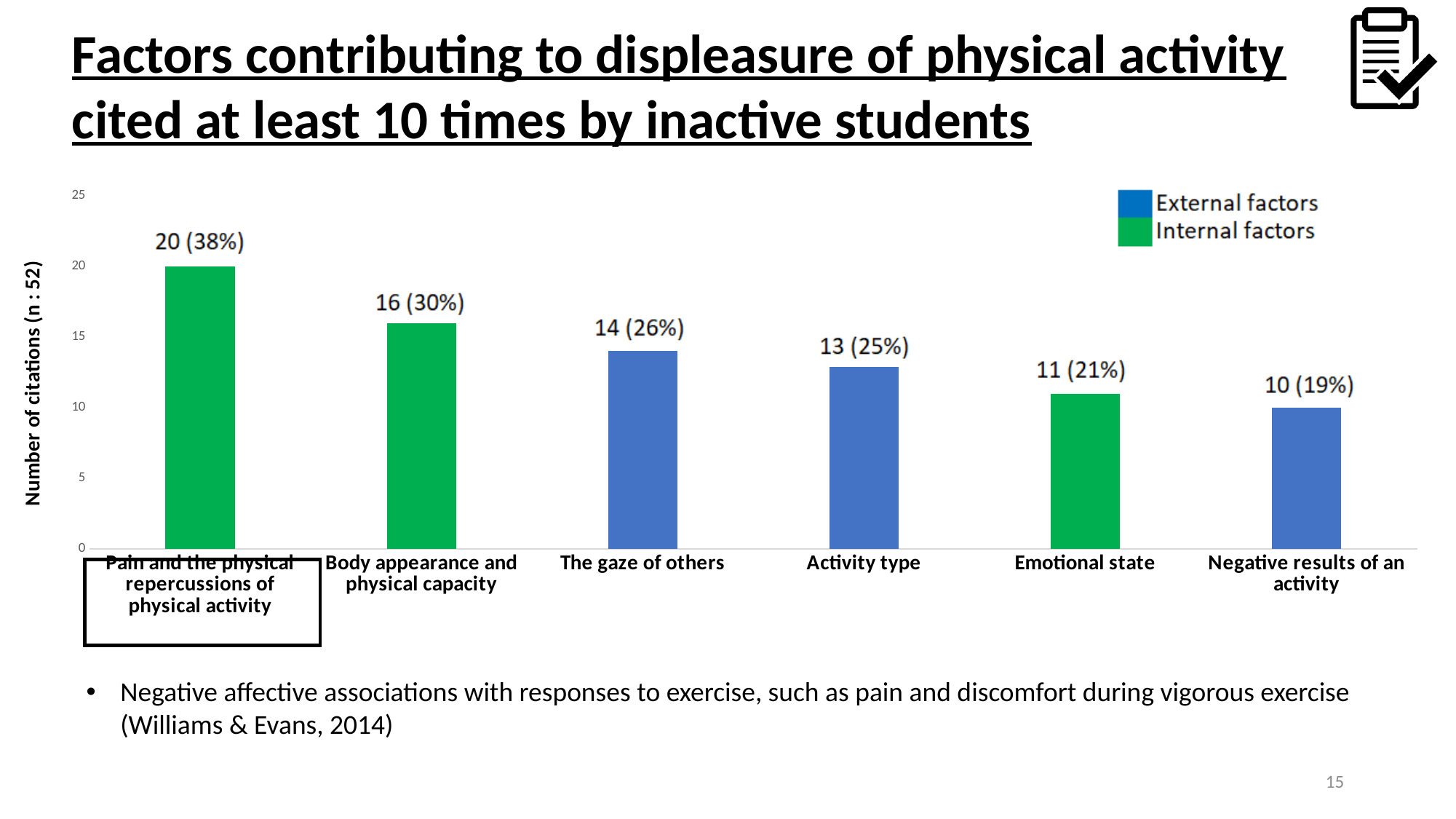
What is the data label on the bar for 'Emotional state'? 11 (21%) Do the values rise or fall from left to right along the x axis? Fall Which factor has the lowest number of citations? Negative results of an activity How many factors (bars) are shown in the chart? 6 Which colour represents 'Internal factors' in the legend? Green What kind of chart is shown on the slide? Bar chart Which factor has the highest number of citations? Pain and the physical repercussions of physical activity How many series does the legend list? 2 What is the difference in citations between 'Body appearance and physical capacity' and 'Activity type'? 3 Which has more citations, 'Activity type' or 'Emotional state'? Activity type What is the label of the vertical axis? Number of citations (n : 52) How many citations does the chart show for 'The gaze of others'? 14 (26%)